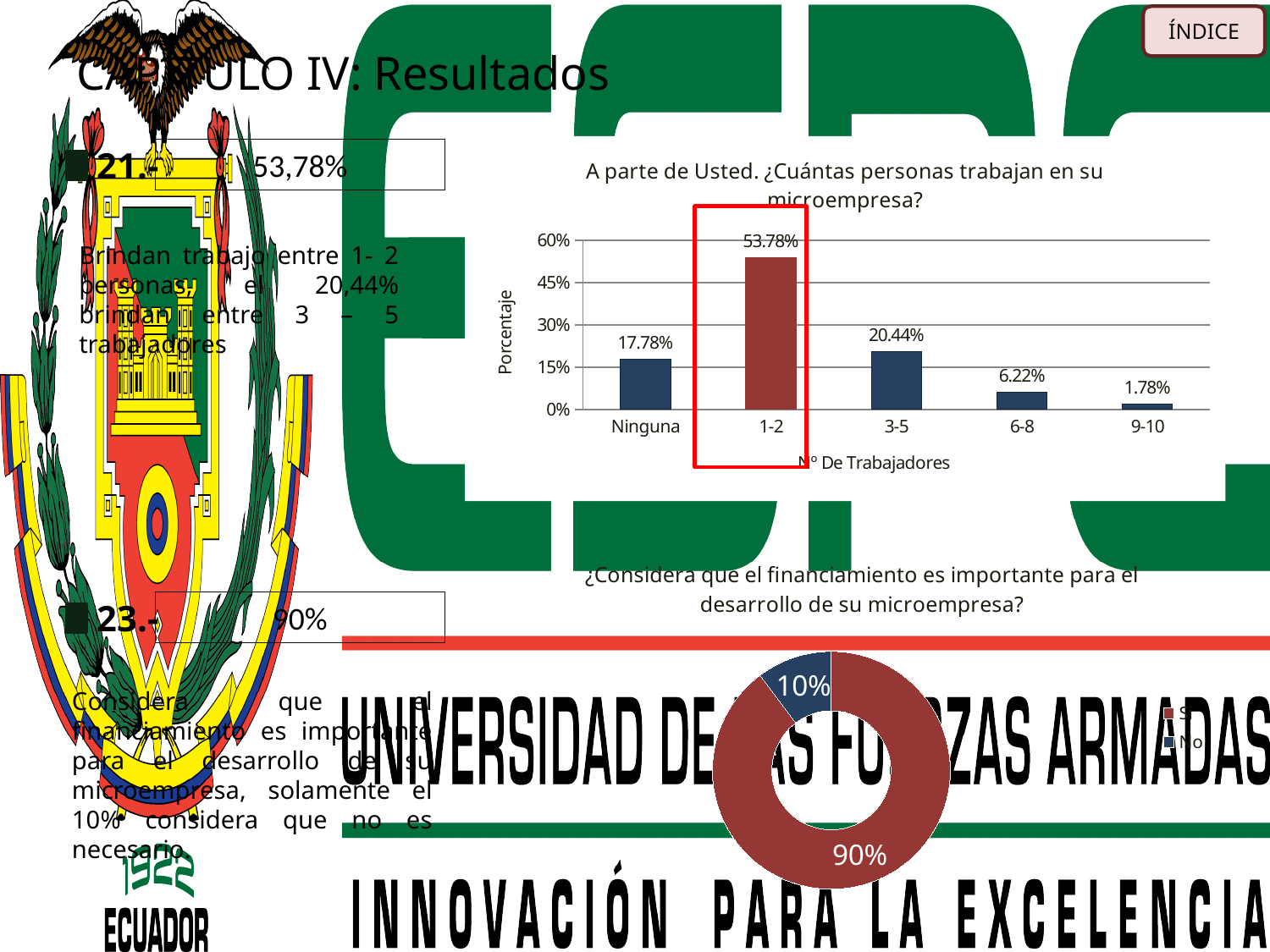
In the bar chart 'A parte de Usted. ¿Cuántas personas trabajan en su microempresa?', what is the label of the y axis? Porcentaje In the bar chart 'A parte de Usted. ¿Cuántas personas trabajan en su microempresa?', which is larger, the value for 'Ninguna' or the value for '3-5'? 3-5 In the bar chart 'A parte de Usted. ¿Cuántas personas trabajan en su microempresa?', what is the value for '6-8'? 6.22% In the doughnut chart '¿Considera que el financiamiento es importante para el desarrollo de su microempresa?', what share does the larger slice have? 90% In the doughnut chart '¿Considera que el financiamiento es importante para el desarrollo de su microempresa?', what share does the 'No' slice have? 10% In the bar chart 'A parte de Usted. ¿Cuántas personas trabajan en su microempresa?', what is the difference between the values for '1-2' and '3-5'? 33.34% In the bar chart 'A parte de Usted. ¿Cuántas personas trabajan en su microempresa?', which category has the highest value? 1-2 What type of chart is the chart titled 'A parte de Usted. ¿Cuántas personas trabajan en su microempresa?'? Bar chart In the bar chart 'A parte de Usted. ¿Cuántas personas trabajan en su microempresa?', which category has the lowest value? 9-10 In the bar chart 'A parte de Usted. ¿Cuántas personas trabajan en su microempresa?', what is the value for the '1-2' category? 53.78% In the bar chart 'A parte de Usted. ¿Cuántas personas trabajan en su microempresa?', how many categories are shown on the x axis? 5 In the bar chart 'A parte de Usted. ¿Cuántas personas trabajan en su microempresa?', what is the value for 'Ninguna'? 17.78%